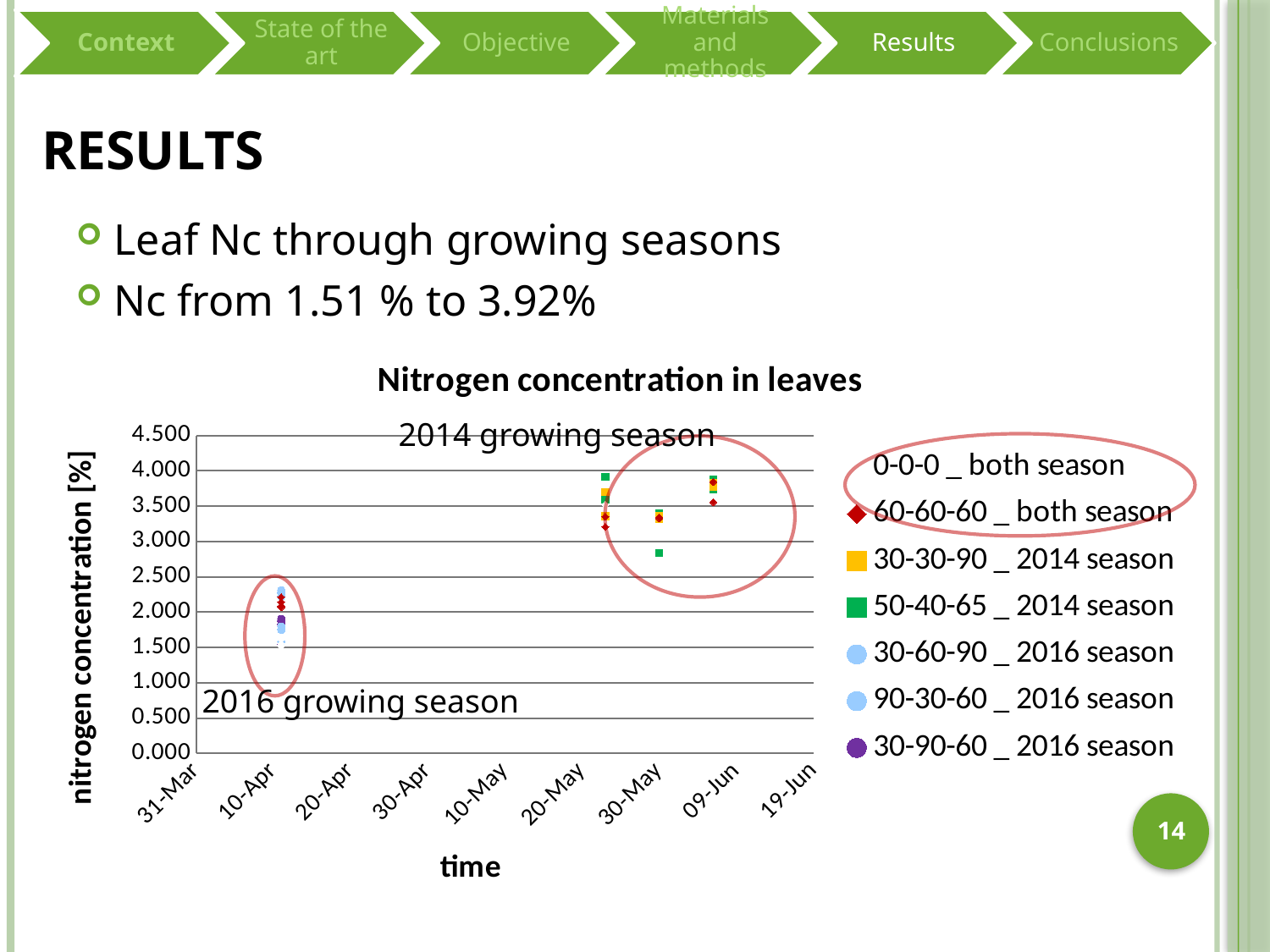
Which is larger: the values for the 50-40-65 _ 2014 season series or the values for the 30-60-90 _ 2016 season series? 50-40-65 _ 2014 season What kind of chart is shown on the slide? scatter chart Do the plotted nitrogen concentration values rise or fall moving from April to June along the x axis? rise How many date ticks are shown along the x axis of the chart? 9 Is the value for the 60-60-60 _ both season series around 10-Apr greater or less than 2.500? less What is the label of the y axis of the chart? nitrogen concentration [%] How many series does the chart legend list? 7 Are the values for the 30-30-90 _ 2014 season series greater or less than 3.000? greater What is the highest tick value shown on the y axis of the chart? 4.500 Are the values for the 50-40-65 _ 2014 season series greater or less than 2.500? greater What is the title of the chart? Nitrogen concentration in leaves